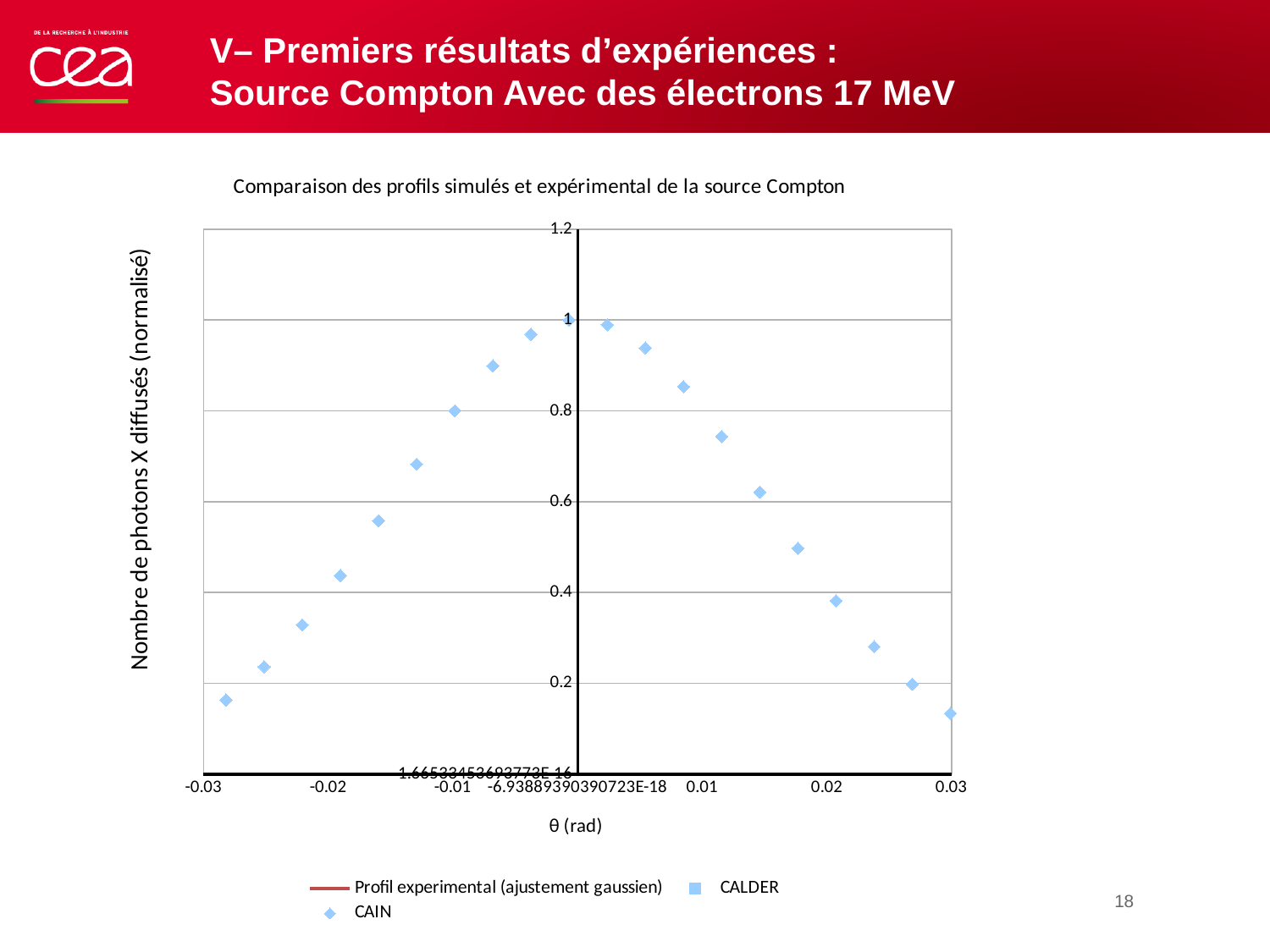
What is the label of the x axis of the chart? θ (rad) Is the value of the leftmost CAIN point (near θ = -0.03) greater or less than 0.2? less Is the highest CAIN point located near the left edge, the centre, or the right edge of the x axis? centre How many series does the chart legend list? 3 Is the value of the CAIN point at θ = 0.03 greater or less than 0.2? less Is the value of the CAIN point at θ = -0.02 greater or less than 0.6? less What is the title of the chart? Comparaison des profils simulés et expérimental de la source Compton Which CAIN point has the larger value: the one at θ = 0.01 or the one at θ = 0.03? θ = 0.01 What kind of chart is shown on the slide? scatter chart Do the CAIN values rise or fall as θ goes from 0 to 0.03? fall Do the CAIN values rise or fall as θ goes from -0.03 to 0? rise